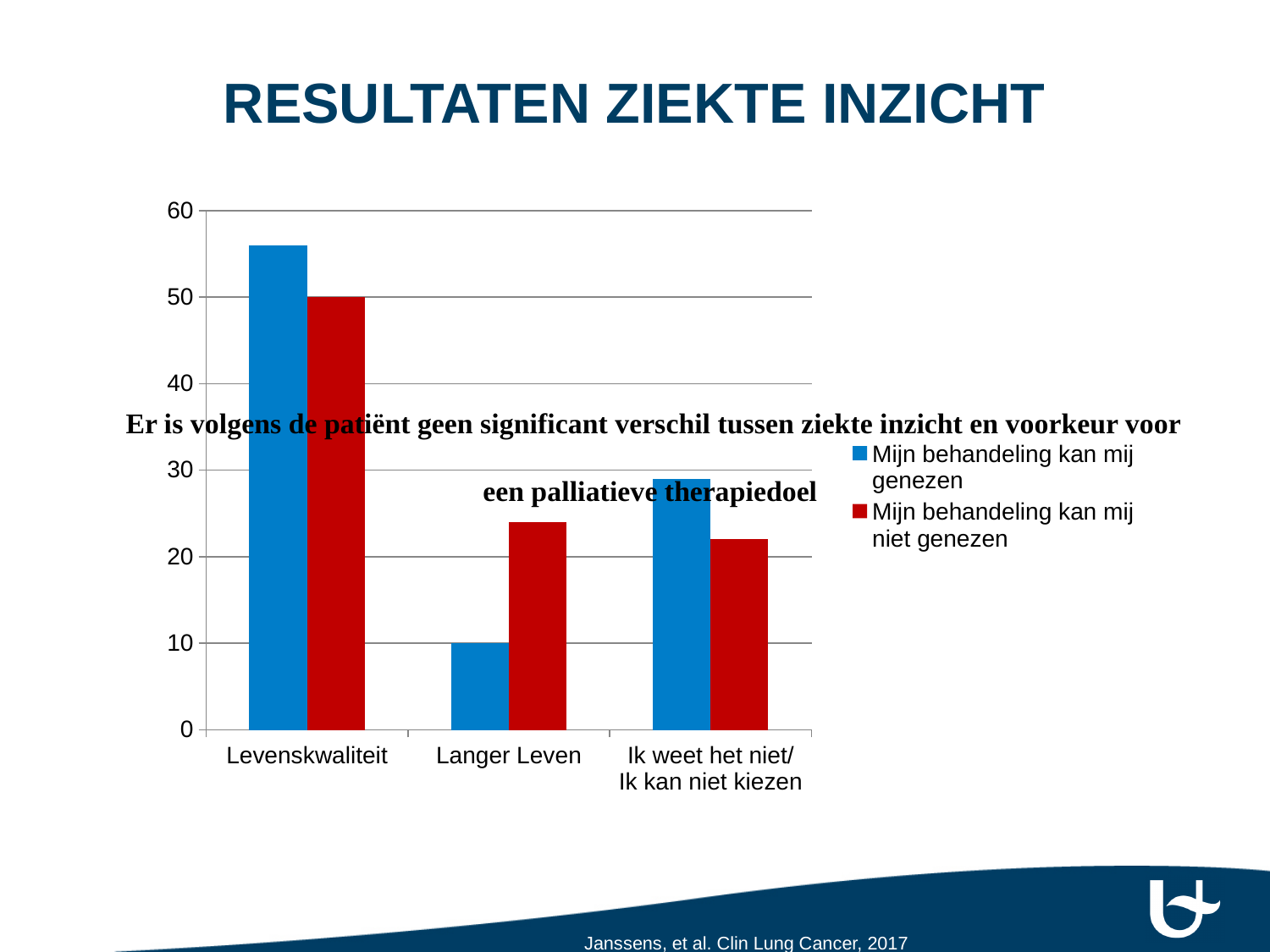
What kind of chart is shown on the slide? bar chart In the Langer Leven category, which series has the larger value? Mijn behandeling kan mij niet genezen Which category has the lowest value for 'Mijn behandeling kan mij genezen'? Langer Leven How many series does the chart's legend list? 2 Which colour represents the series 'Mijn behandeling kan mij niet genezen' in the chart? red Is the value for 'Mijn behandeling kan mij genezen' in the Levenskwaliteit category greater or less than 50? greater What is the value for 'Mijn behandeling kan mij genezen' in the Langer Leven category? 10 Which category has the highest value for 'Mijn behandeling kan mij genezen'? Levenskwaliteit Is the value for 'Mijn behandeling kan mij niet genezen' in the Langer Leven category greater or less than 20? greater What is the value for 'Mijn behandeling kan mij niet genezen' in the Levenskwaliteit category? 50 How many categories are shown on the x axis of the chart? 3